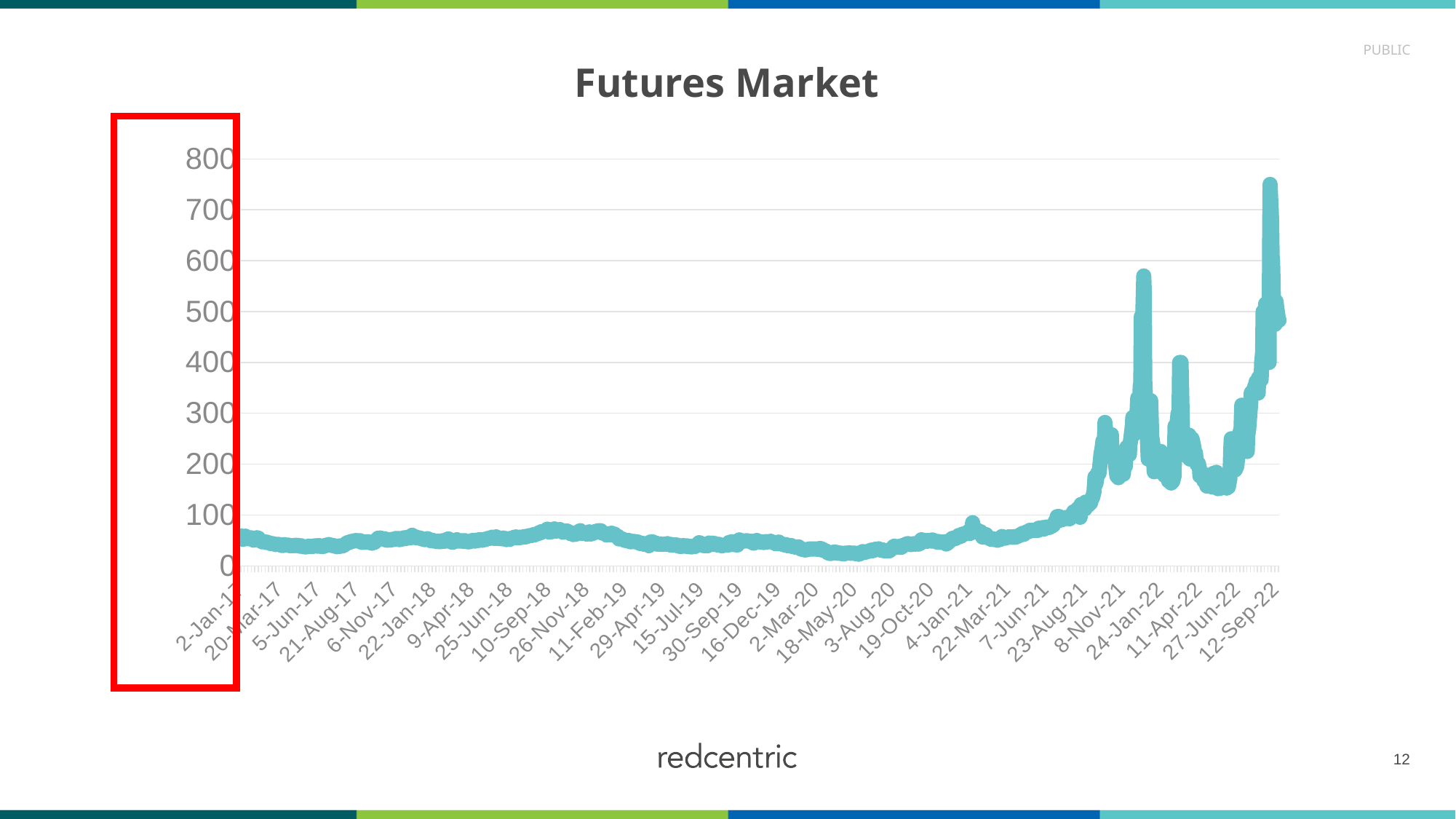
Is the value at 2-Mar-20 greater or less than 100? less Is the value at 12-Sep-22 larger or smaller than the value at 2-Jan-17? Larger Is the value at 7-Jun-21 greater or less than 200? less What is the title of the chart? Futures Market Is the value at 2-Jan-17 greater or less than 100? less What colour is the plotted line in the chart? Teal What is the highest value shown on the vertical axis? 800 What kind of chart is shown on the slide? Line chart In which year does the line reach its highest point? 2022 Overall, do the values rise or fall from 2-Jan-17 to 12-Sep-22? Rise